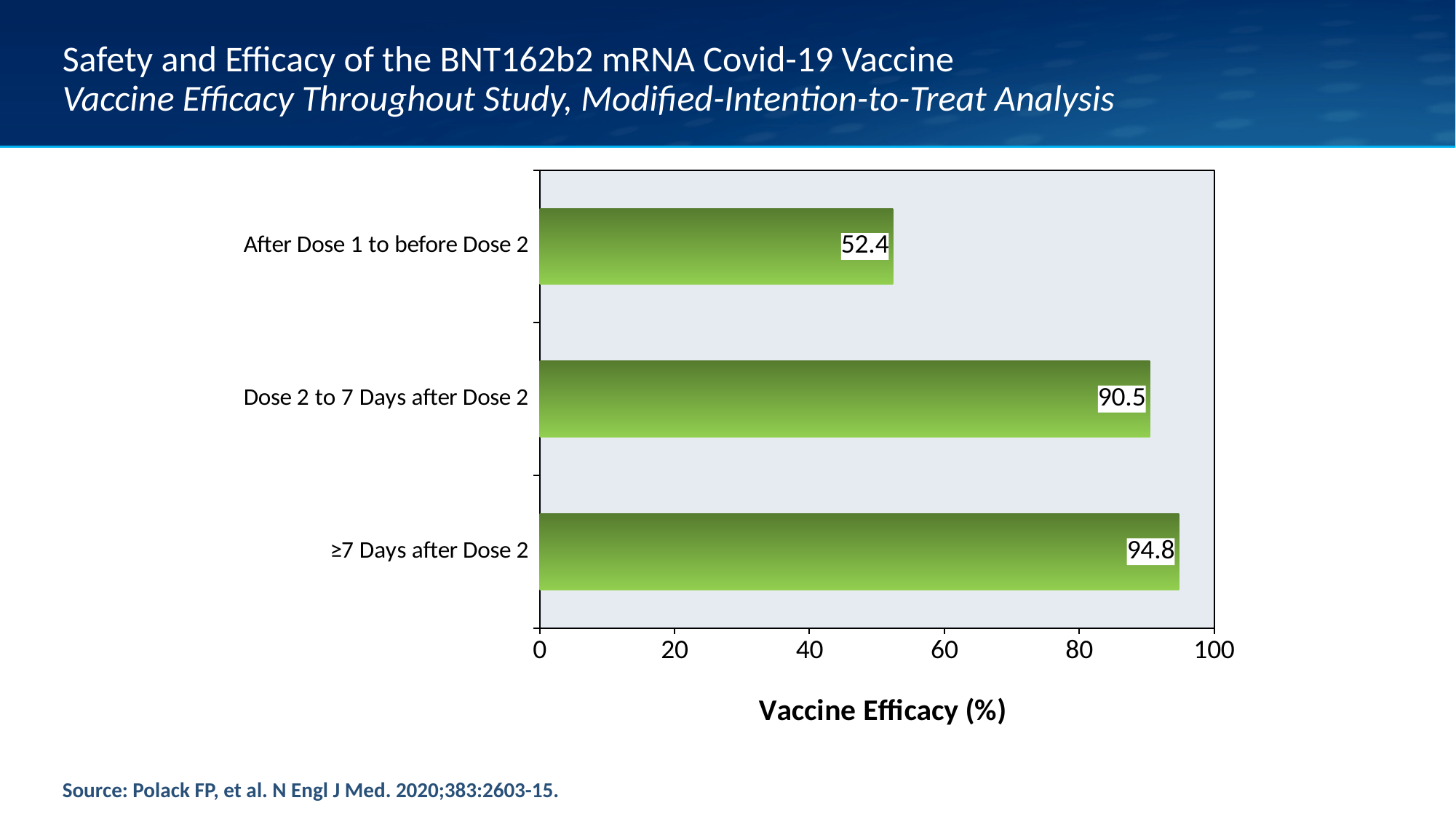
What is the difference in vaccine efficacy between ≥7 Days after Dose 2 and After Dose 1 to before Dose 2? 42.4 Which has a higher vaccine efficacy: Dose 2 to 7 Days after Dose 2 or After Dose 1 to before Dose 2? Dose 2 to 7 Days after Dose 2 What is the vaccine efficacy for the period After Dose 1 to before Dose 2? 52.4 Which period has the lowest vaccine efficacy? After Dose 1 to before Dose 2 Which period has the highest vaccine efficacy? ≥7 Days after Dose 2 What is the label of the horizontal axis? Vaccine Efficacy (%) How many periods are shown in the chart? 3 What is the vaccine efficacy for the period ≥7 Days after Dose 2? 94.8 What kind of chart is shown on the slide? Bar chart Is the vaccine efficacy for After Dose 1 to before Dose 2 greater or less than 60? less What is the vaccine efficacy for the period Dose 2 to 7 Days after Dose 2? 90.5 What is the difference in vaccine efficacy between ≥7 Days after Dose 2 and Dose 2 to 7 Days after Dose 2? 4.3